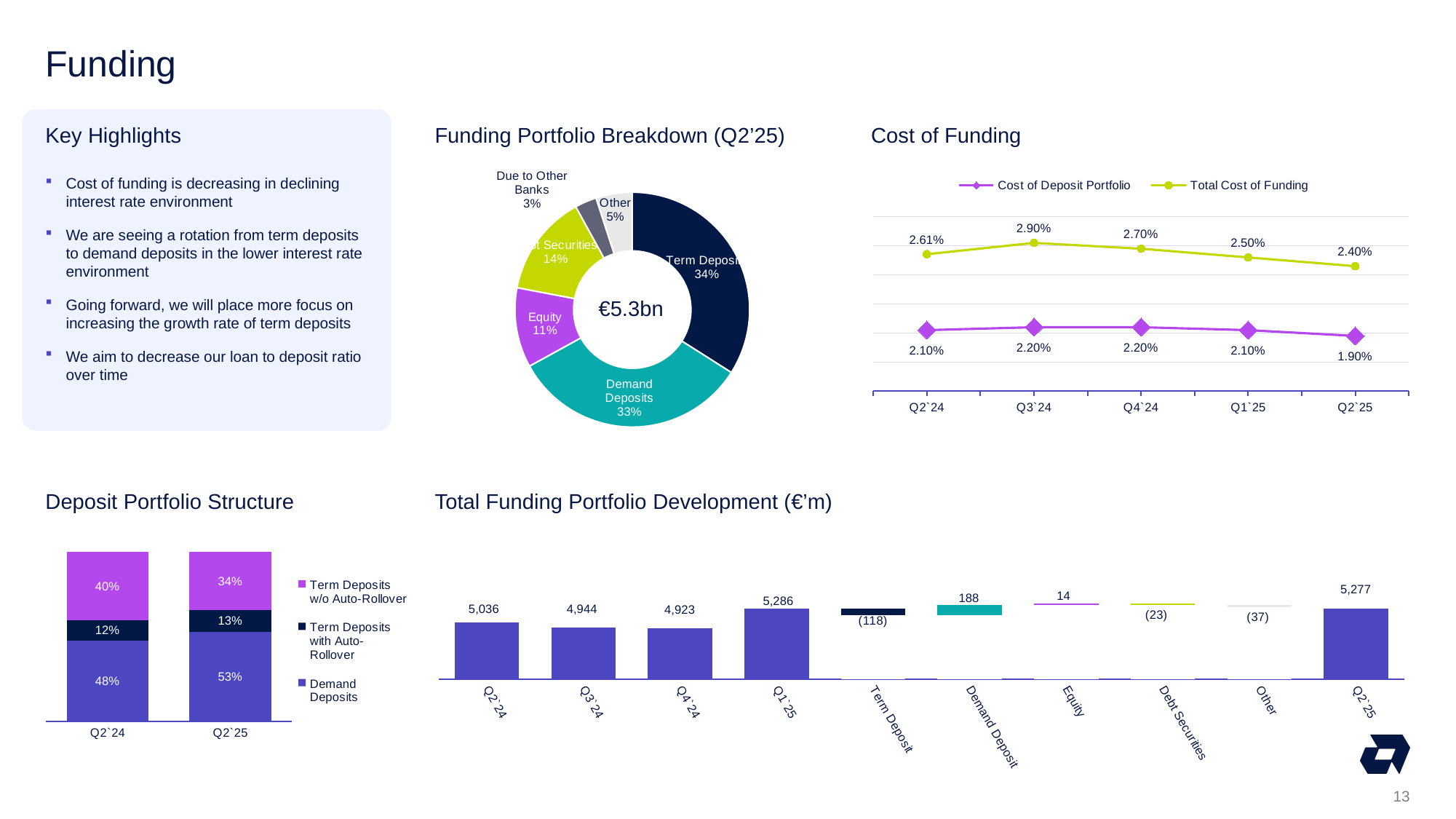
In the Funding Portfolio Breakdown (Q2'25) chart, which segment is the smallest? Due to Other Banks In the Funding Portfolio Breakdown (Q2'25) chart, what share do Term Deposits represent? 34% In the Total Funding Portfolio Development (€'m) chart, what is the value for Demand Deposit? 188 In the Cost of Funding chart, what is the difference between Total Cost of Funding and Cost of Deposit Portfolio in Q2`24? 0.51% In the Cost of Funding chart, does the Total Cost of Funding rise or fall from Q3`24 to Q2`25? fall In the Funding Portfolio Breakdown (Q2'25) chart, what is the total value shown in the centre of the donut? €5.3bn In the Cost of Funding chart, what is the Total Cost of Funding in Q3`24? 2.90% In the Total Funding Portfolio Development (€'m) chart, what is the value for Q1`25? 5,286 In the Deposit Portfolio Structure chart, what share do Demand Deposits represent in Q2`25? 53% In the Cost of Funding chart, how many series does the legend list? 2 In the Cost of Funding chart, what is the Cost of Deposit Portfolio in Q2`25? 1.90% In the Deposit Portfolio Structure chart, what kind of chart is shown? stacked bar chart